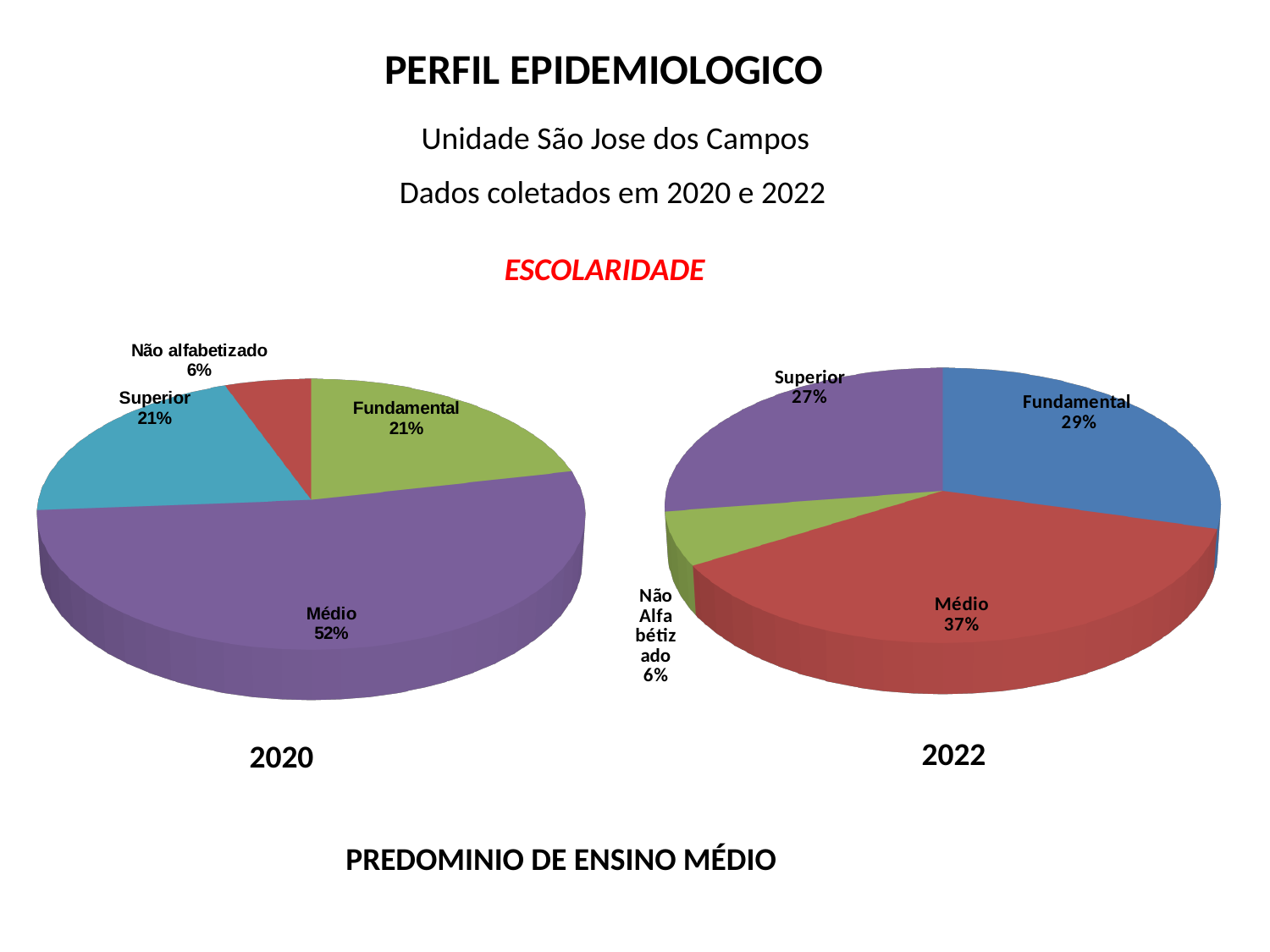
In the 2020 pie chart, what share is labelled for Não alfabetizado? 6% What type of chart is used for the 2020 data? Pie chart What is the difference between the Médio share in the 2020 chart and the Médio share in the 2022 chart? 15% In the 2020 pie chart, which category has the largest slice? Médio In the 2020 pie chart, what is the difference between the Médio share and the Superior share? 31% In the 2020 pie chart, what share is labelled for Médio? 52% How many slices does the 2020 pie chart have? 4 In the 2022 pie chart, what share is labelled for Fundamental? 29% In the 2022 pie chart, what share is labelled for Superior? 27% In the 2022 pie chart, which category has the largest slice? Médio In the 2022 pie chart, which is larger, the Fundamental slice or the Superior slice? Fundamental In the 2022 pie chart, which category has the smallest slice? Não Alfabetizado